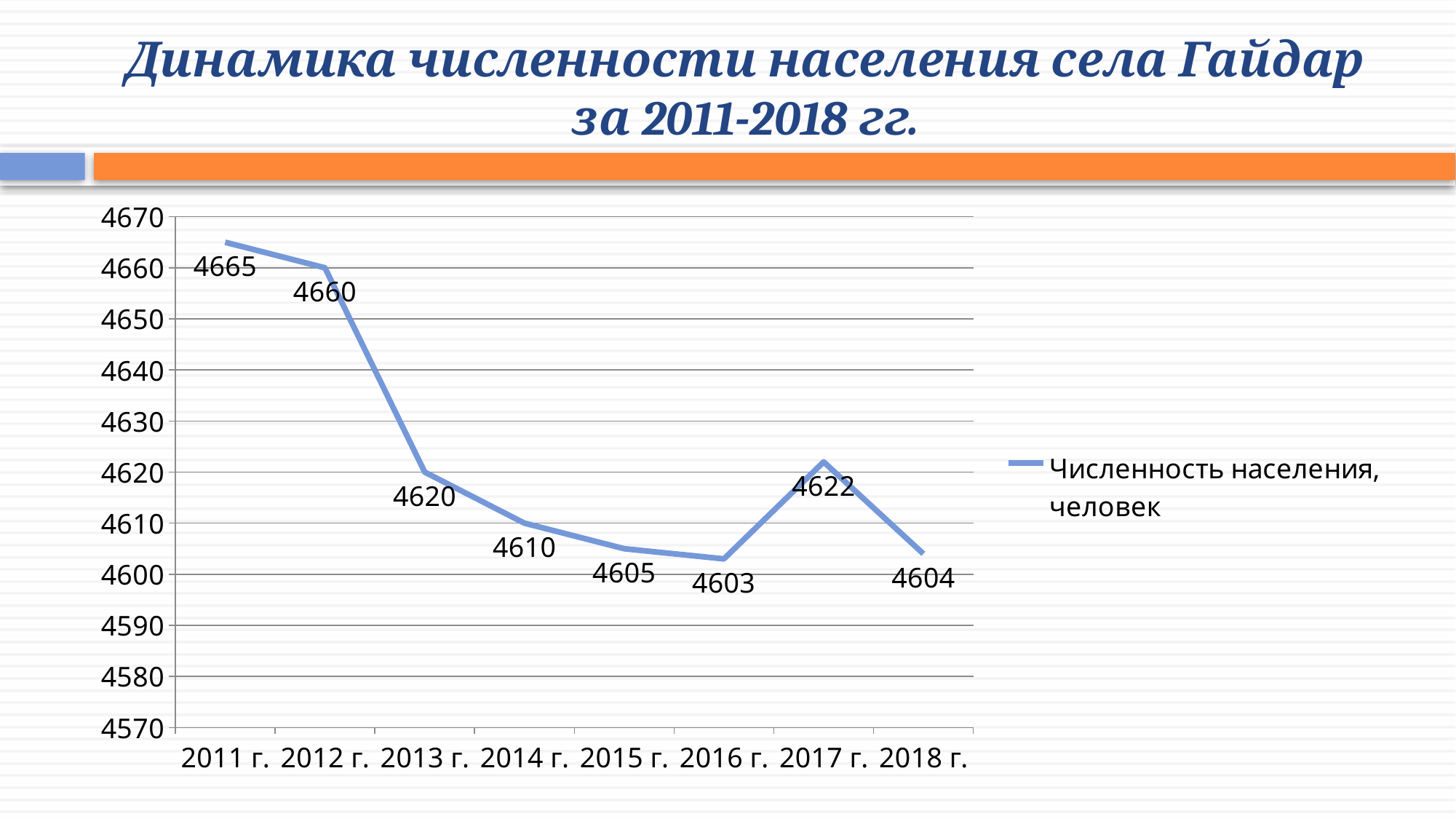
What is the difference between the population in 2011 г. and 2018 г.? 61 What is the population value for 2018 г.? 4604 Which is larger, the population in 2014 г. or in 2017 г.? 2017 г. What is the population value for 2017 г.? 4622 What is the population value for 2013 г.? 4620 How many years are plotted on the x axis? 8 What is the difference between the population in 2012 г. and 2013 г.? 40 Which year has the highest population value? 2011 г. What kind of chart is shown on the slide? line chart What is the legend entry for the plotted series? Численность населения, человек Which year has the lowest population value? 2016 г. Is the value for 2015 г. greater or less than 4610? less